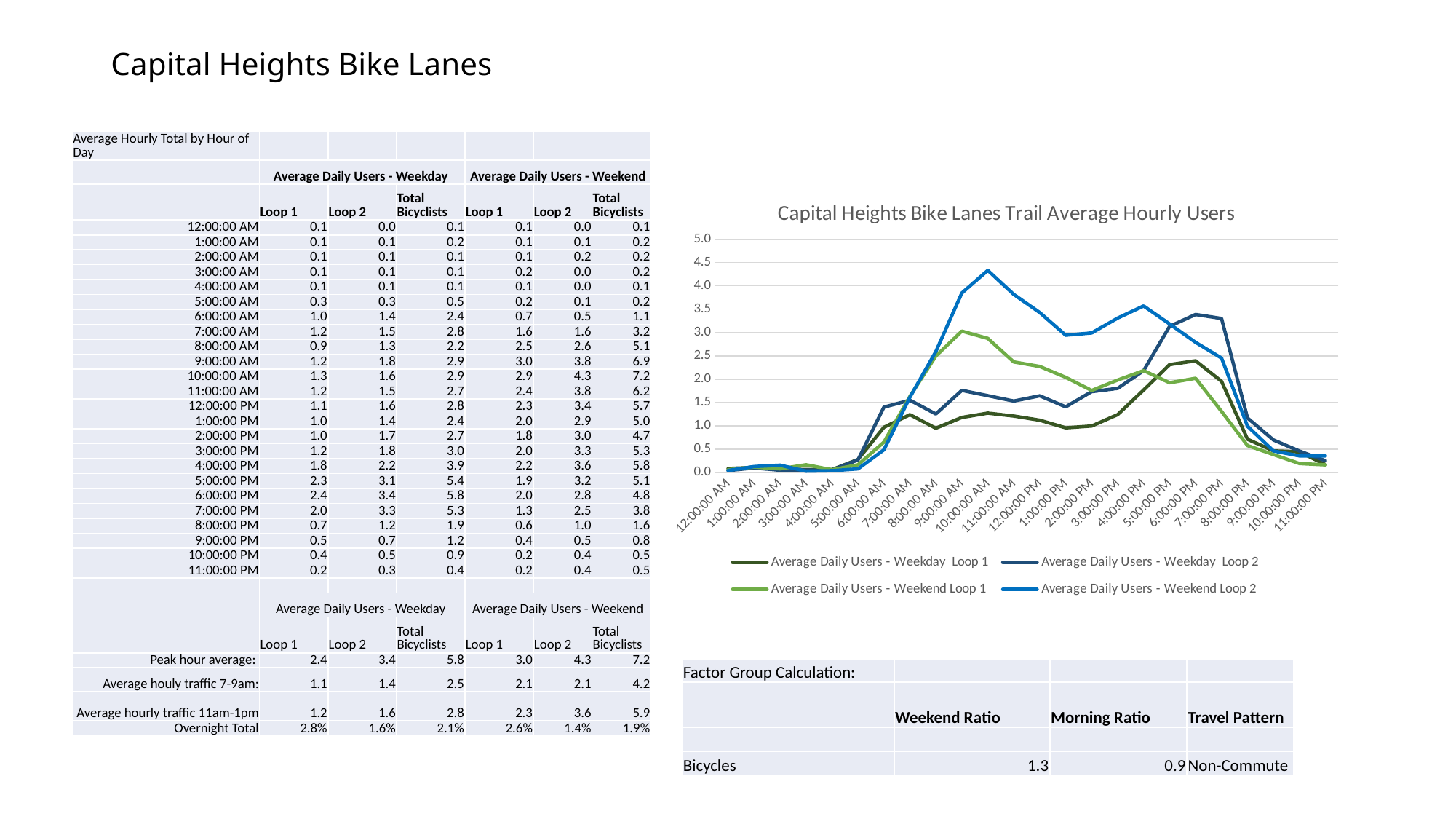
Which series reaches the highest value on the chart? Average Daily Users - Weekend Loop 2 What is the difference between Average Daily Users - Weekend Loop 2 and Average Daily Users - Weekday Loop 2 at 10:00:00 AM? 2.7 Does the Average Daily Users - Weekend Loop 2 line rise or fall from 10:00:00 AM to 1:00:00 PM? fall At 9:00:00 AM, which is larger: Average Daily Users - Weekend Loop 1 or Average Daily Users - Weekday Loop 1? Average Daily Users - Weekend Loop 1 Is the value for Average Daily Users - Weekday Loop 1 at 5:00:00 PM greater or less than 2.0? greater What is the title of the chart? Capital Heights Bike Lanes Trail Average Hourly Users How many series does the chart legend list? 4 What is the value for Average Daily Users - Weekday Loop 2 at 6:00:00 PM? 3.4 What is the value for Average Daily Users - Weekend Loop 2 at 10:00:00 AM? 4.3 How many hourly points are plotted along the x axis of the chart? 24 At which hour does Average Daily Users - Weekday Loop 2 reach its highest value? 6:00:00 PM What kind of chart is shown on the slide? line chart